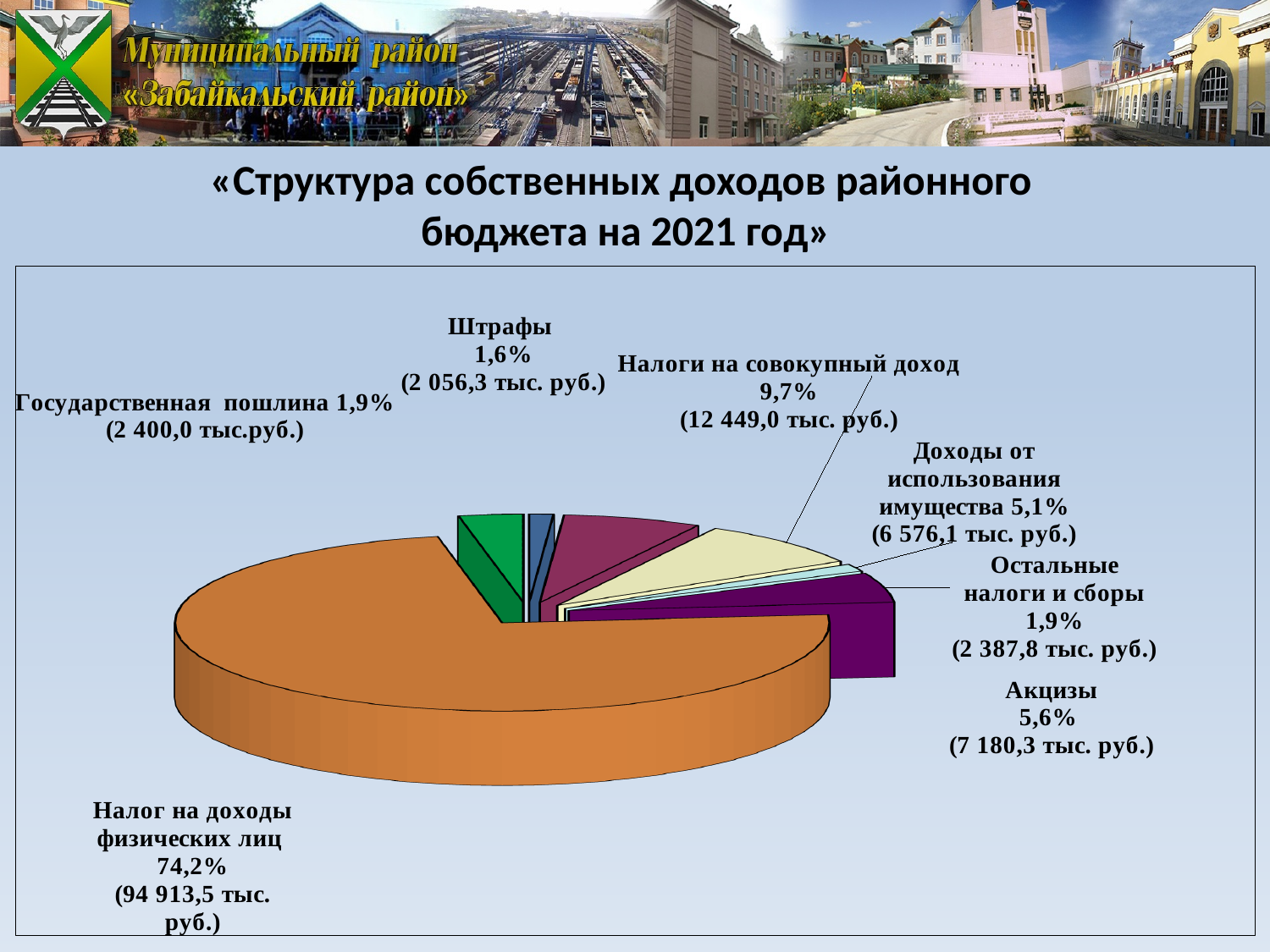
Which category has the smallest share of the pie? Штрафы What share of the district budget's own revenues comes from Налог на доходы физических лиц? 74,2% What percentage is shown for Доходы от использования имущества? 5,1% What type of chart is shown on the slide? Pie chart What amount in thousand rubles is shown for Налоги на совокупный доход? 12 449,0 тыс. руб. What percentage is shown for Акцизы? 5,6% Which is larger: the share for Налоги на совокупный доход or the share for Акцизы? Налоги на совокупный доход What amount is shown for Штрафы? 2 056,3 тыс. руб. Which category has the largest share of the pie? Налог на доходы физических лиц What is the difference in percentage points between Налоги на совокупный доход (9,7%) and Доходы от использования имущества (5,1%)? 4,6 What is the title of the chart on the slide? «Структура собственных доходов районного бюджета на 2021 год» How many categories are shown in the pie chart? 7